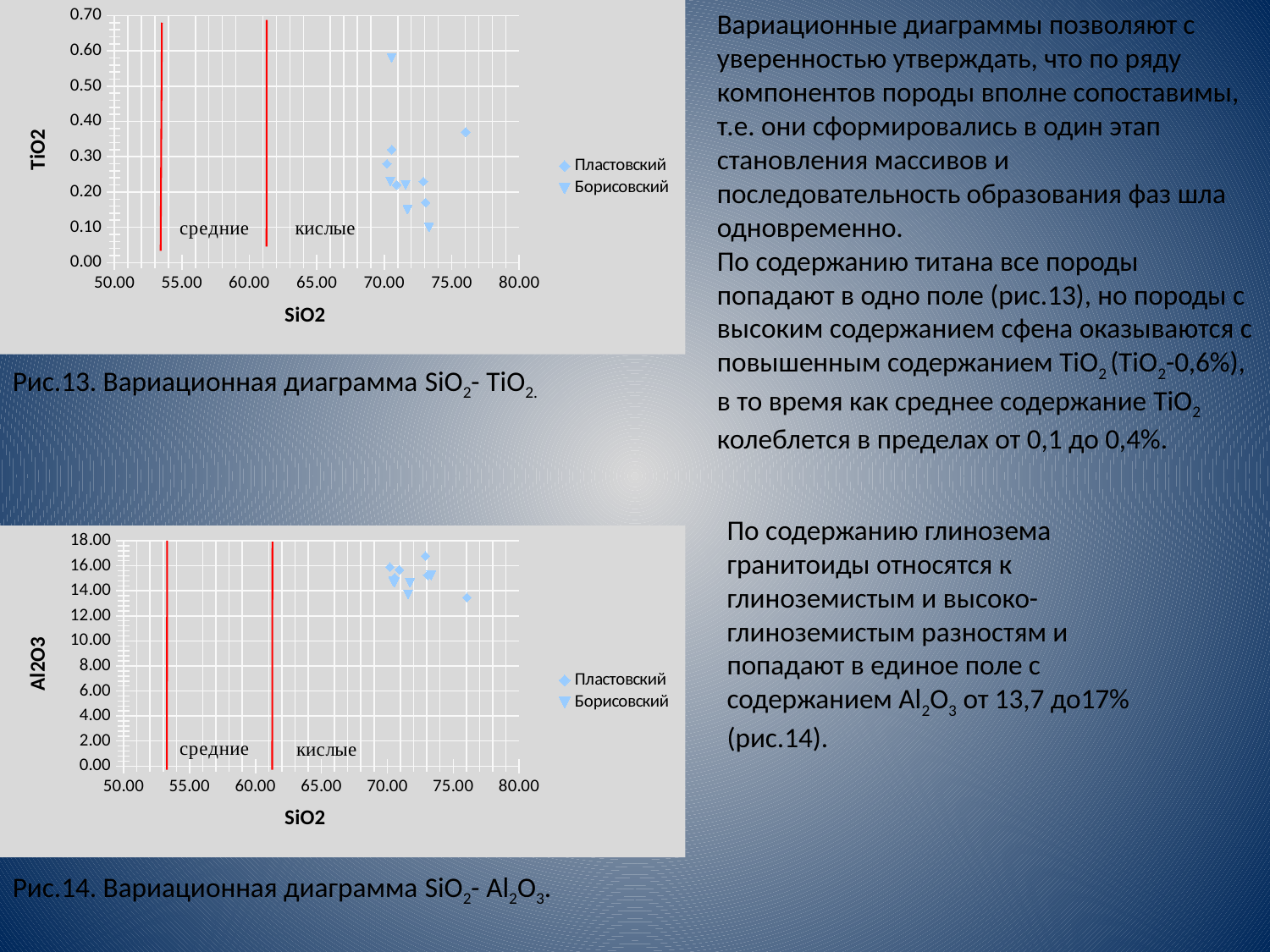
In the top chart, is the highest TiO2 value plotted greater or less than 0.50? greater What kind of chart is the bottom chart (Рис.14)? scatter chart What is the label of the vertical axis on the top chart? TiO2 In the bottom chart, are all plotted Al2O3 values greater or less than 18.00? less What is the label of the horizontal axis on the bottom chart? SiO2 In the top chart, is the lowest TiO2 value plotted greater or less than 0.20? less How many series does the legend of the bottom chart list? 2 What kind of chart is the top chart (Рис.13)? scatter chart How many series does the legend of the top chart list? 2 What is the label of the vertical axis on the bottom chart? Al2O3